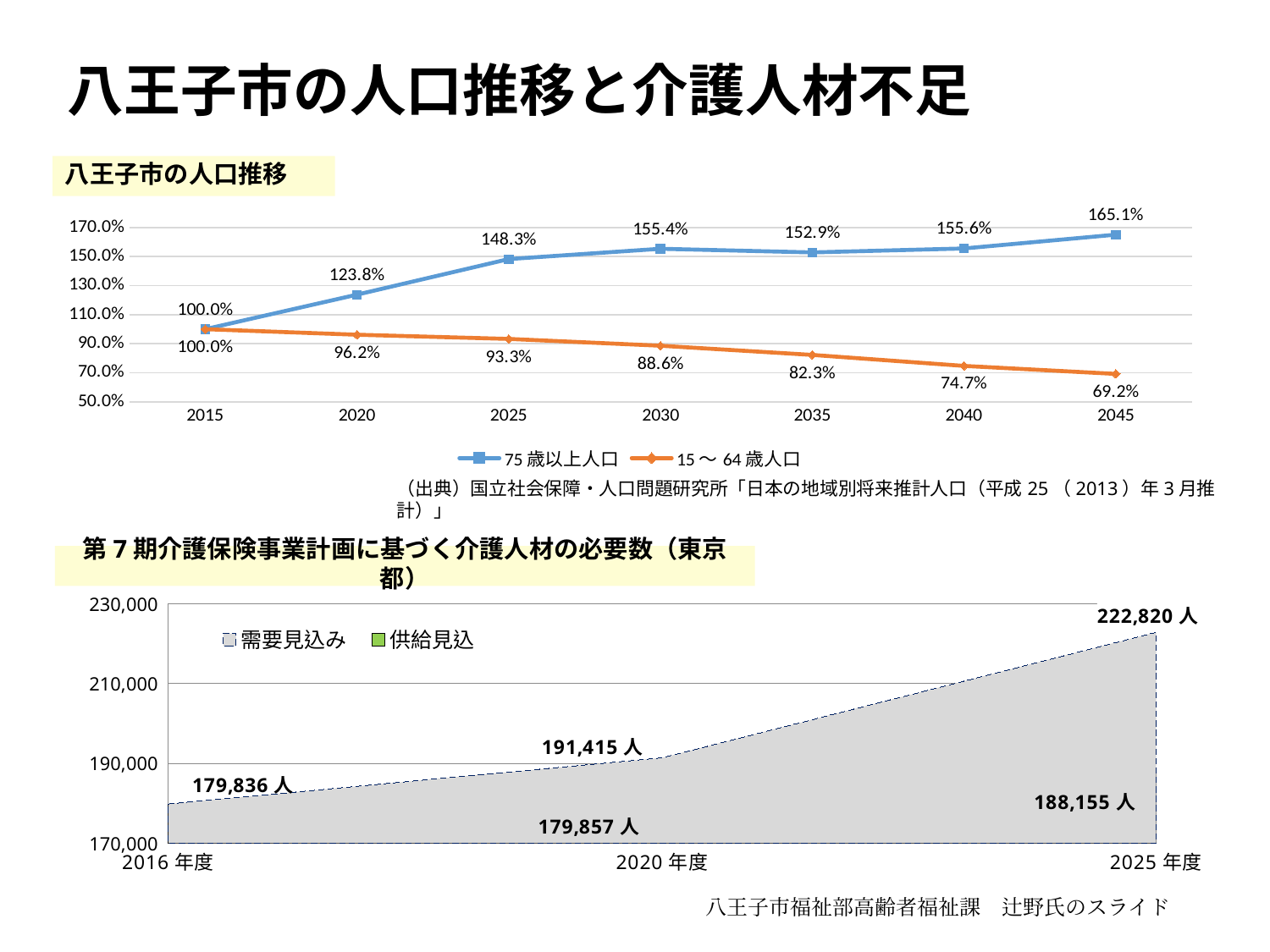
In the top chart (八王子市の人口推移), is the 75歳以上人口 value larger in 2030 or in 2035? 2030 In the top chart (八王子市の人口推移), does the 15～64歳人口 series rise or fall from 2015 to 2045? Fall In the top chart (八王子市の人口推移), what is the difference between the 75歳以上人口 value and the 15～64歳人口 value in 2025? 55.0 percentage points In the top chart (八王子市の人口推移), what is the value for 15～64歳人口 in 2035? 82.3% What kind of chart is the top chart (八王子市の人口推移)? Line chart In the bottom chart (第7期介護保険事業計画に基づく介護人材の必要数), what is the 需要見込み value for 2025年度? 222,820人 In the top chart (八王子市の人口推移), how many years are plotted on the x axis? 7 In the bottom chart (第7期介護保険事業計画に基づく介護人材の必要数), what is the difference between the 需要見込み values for 2025年度 and 2016年度? 42,984人 In the top chart (八王子市の人口推移), how many series does the legend list? 2 In the top chart (八王子市の人口推移), what is the value for 75歳以上人口 in 2045? 165.1% In the top chart (八王子市の人口推移), in which year is the 15～64歳人口 value lowest? 2045 In the top chart (八王子市の人口推移), in which year is the 75歳以上人口 value highest? 2045